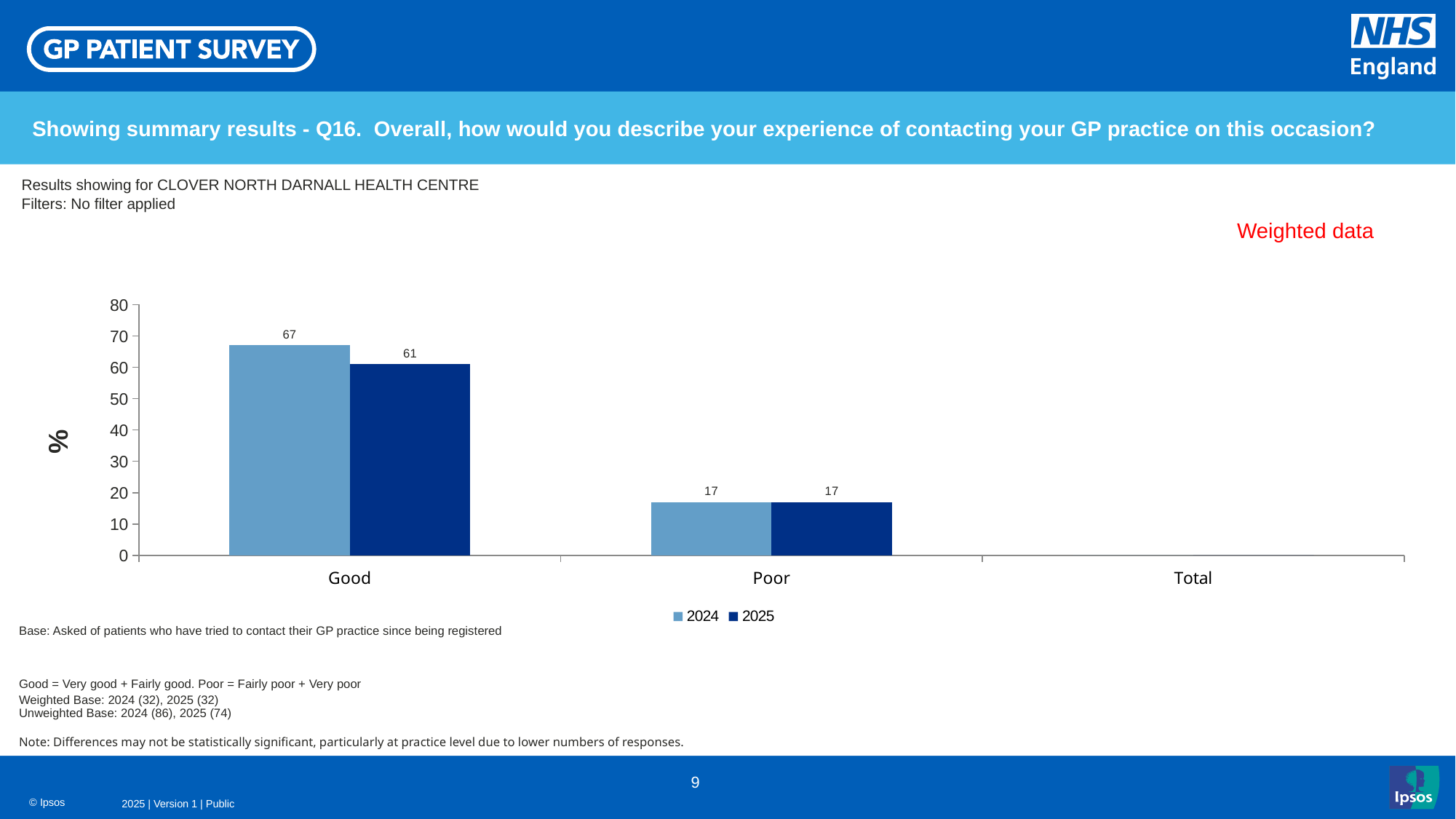
What is the difference between the 2024 and 2025 values for Good? 6 What is the label on the y axis? % Which series is shown in the darker blue colour? 2025 Which is larger for Good: the 2024 value or the 2025 value? 2024 What is the value for Poor in 2025? 17 What is the value for Good in 2024? 67 What kind of chart is shown? bar chart What is the difference between the Good and Poor values in 2025? 44 How many series does the legend list? 2 What is the value for Good in 2025? 61 Is the value for Poor in 2024 greater or less than 20? less Which category has the highest value in 2025? Good